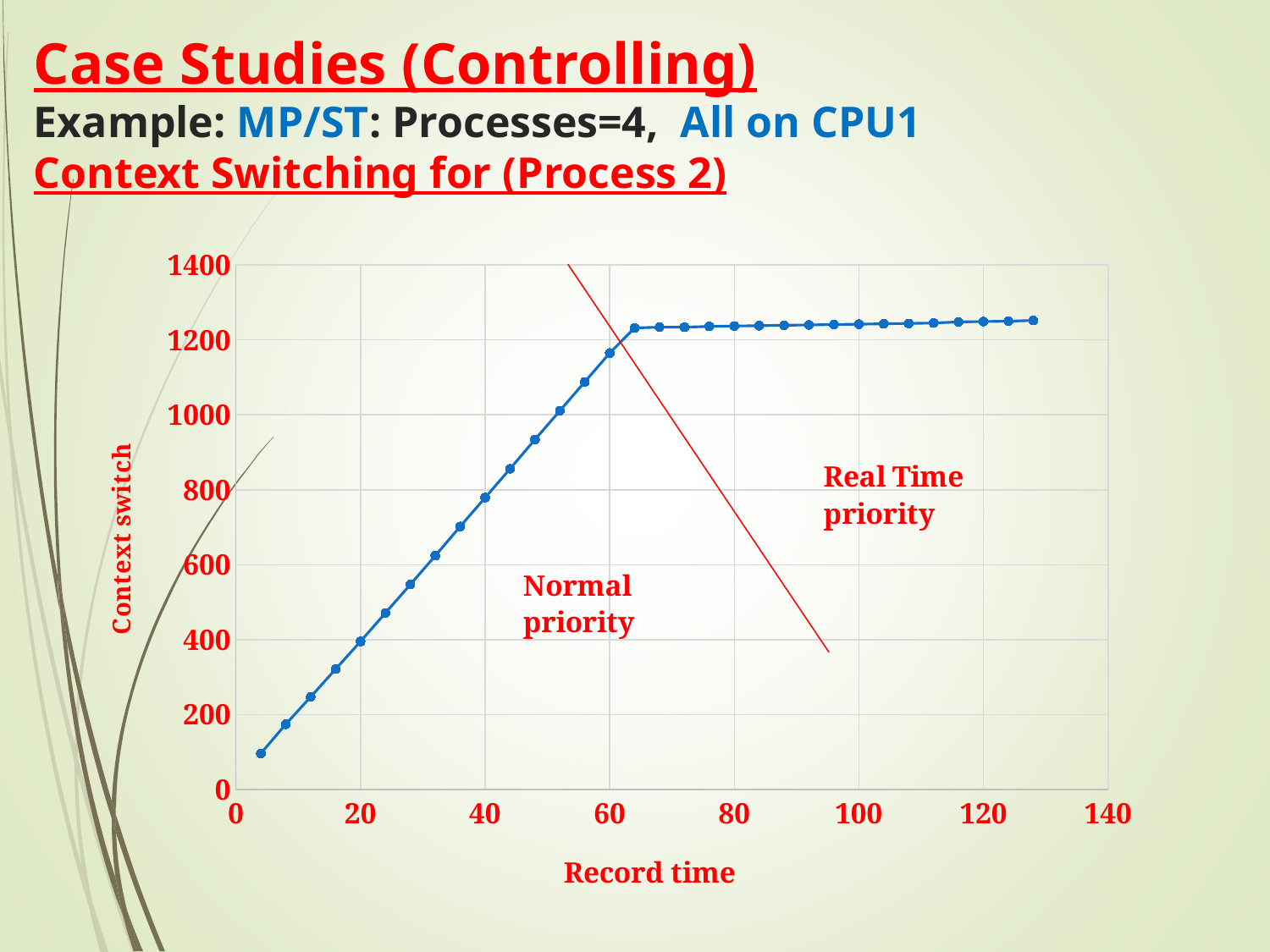
What kind of chart is shown on the slide? Line chart Does the context switch value rise or fall as record time increases from 0 to 60? rise What is the title of the y axis of the chart? Context switch What is the title of the x axis of the chart? Record time Is the context switch value at record time 28 greater or less than 400? greater Is the context switch value at record time 60 greater or less than 1200? less Is the context switch value at record time 80 greater or less than 1000? greater Which has the larger context switch value: record time 40 or record time 120? record time 120 What is the highest value shown on the y axis of the chart? 1400